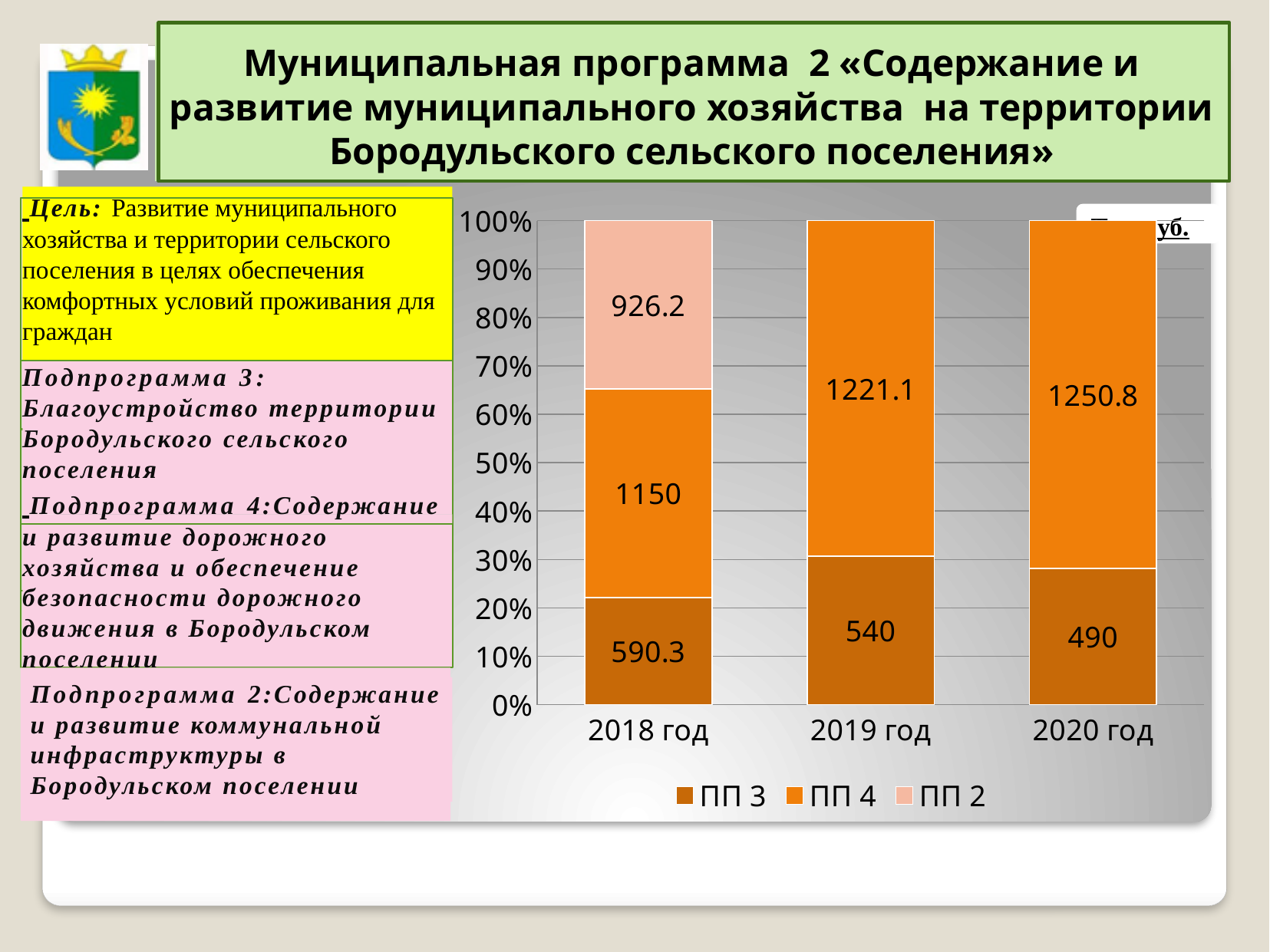
In which year is the value of ПП 4 the lowest? 2018 год What kind of chart is shown on the slide? Stacked bar chart How many series does the legend list? 3 In which year is the value of ПП 3 the highest? 2018 год What is the difference between the ПП 4 values for 2020 год and 2019 год? 29.7 How many years are shown on the x axis? 3 What is the value of ПП 4 for 2019 год? 1221.1 What is the value of ПП 3 for 2020 год? 490 Does the value of ПП 3 rise or fall from 2018 год to 2020 год? fall What is the value of ПП 2 for 2018 год? 926.2 Which is larger: ПП 3 in 2019 год or ПП 3 in 2020 год? ПП 3 in 2019 год Is the share of ПП 3 in the 2018 год bar greater or less than 30%? less